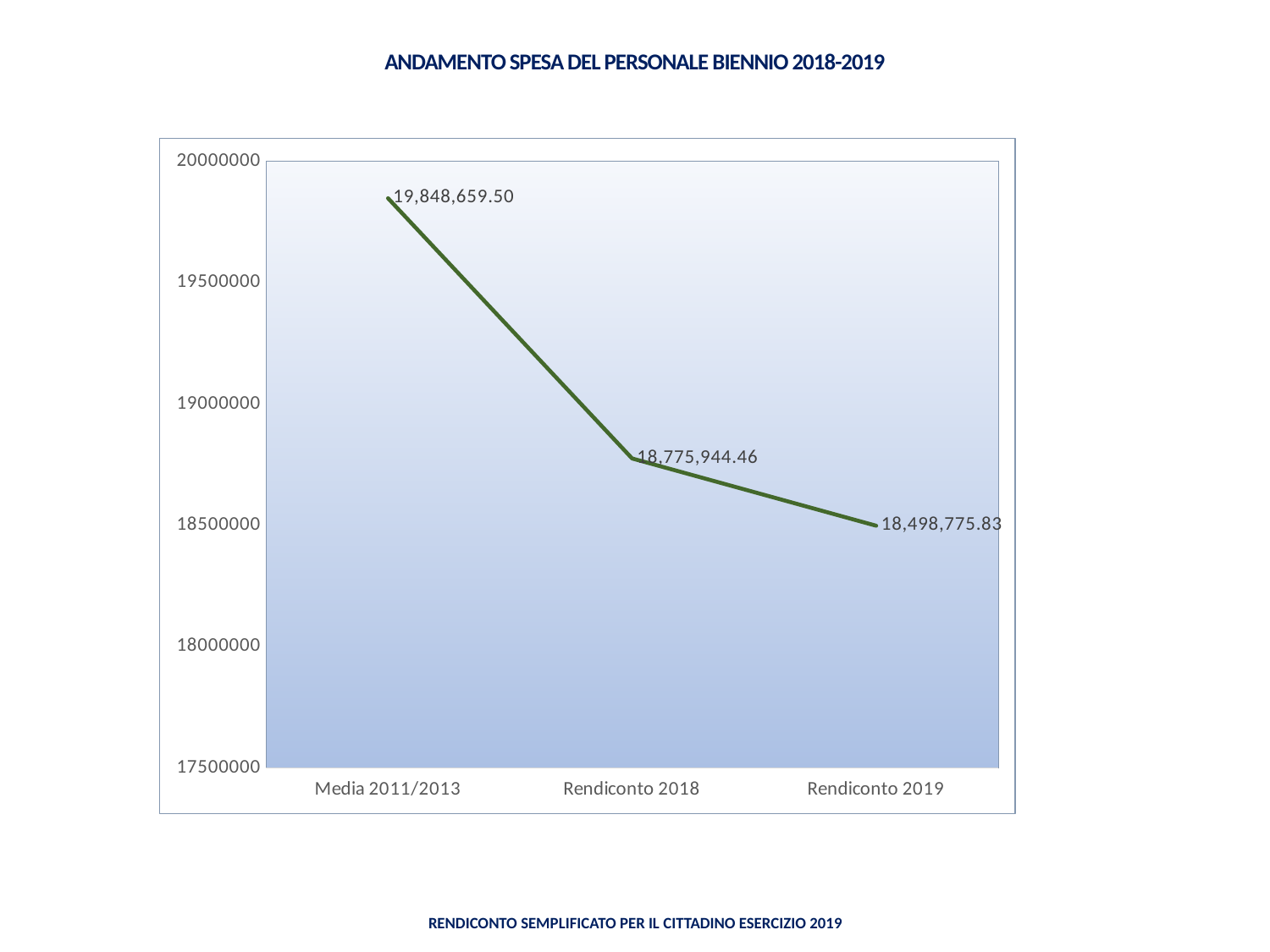
What is the difference between the values for Media 2011/2013 and Rendiconto 2018? 1,072,715.04 What is the value for Rendiconto 2018? 18,775,944.46 What is the value for Rendiconto 2019? 18,498,775.83 What is the value for Media 2011/2013? 19,848,659.50 What kind of chart is shown on the slide? line chart Which category has the highest value? Media 2011/2013 Which category has the lowest value? Rendiconto 2019 What is the difference between the values for Rendiconto 2018 and Rendiconto 2019? 277,168.63 Do the values rise or fall from Media 2011/2013 to Rendiconto 2019? fall How many categories are plotted on the x axis? 3 Is the value for Rendiconto 2018 greater or less than 19000000? less Which is larger, the value for Rendiconto 2018 or the value for Rendiconto 2019? Rendiconto 2018